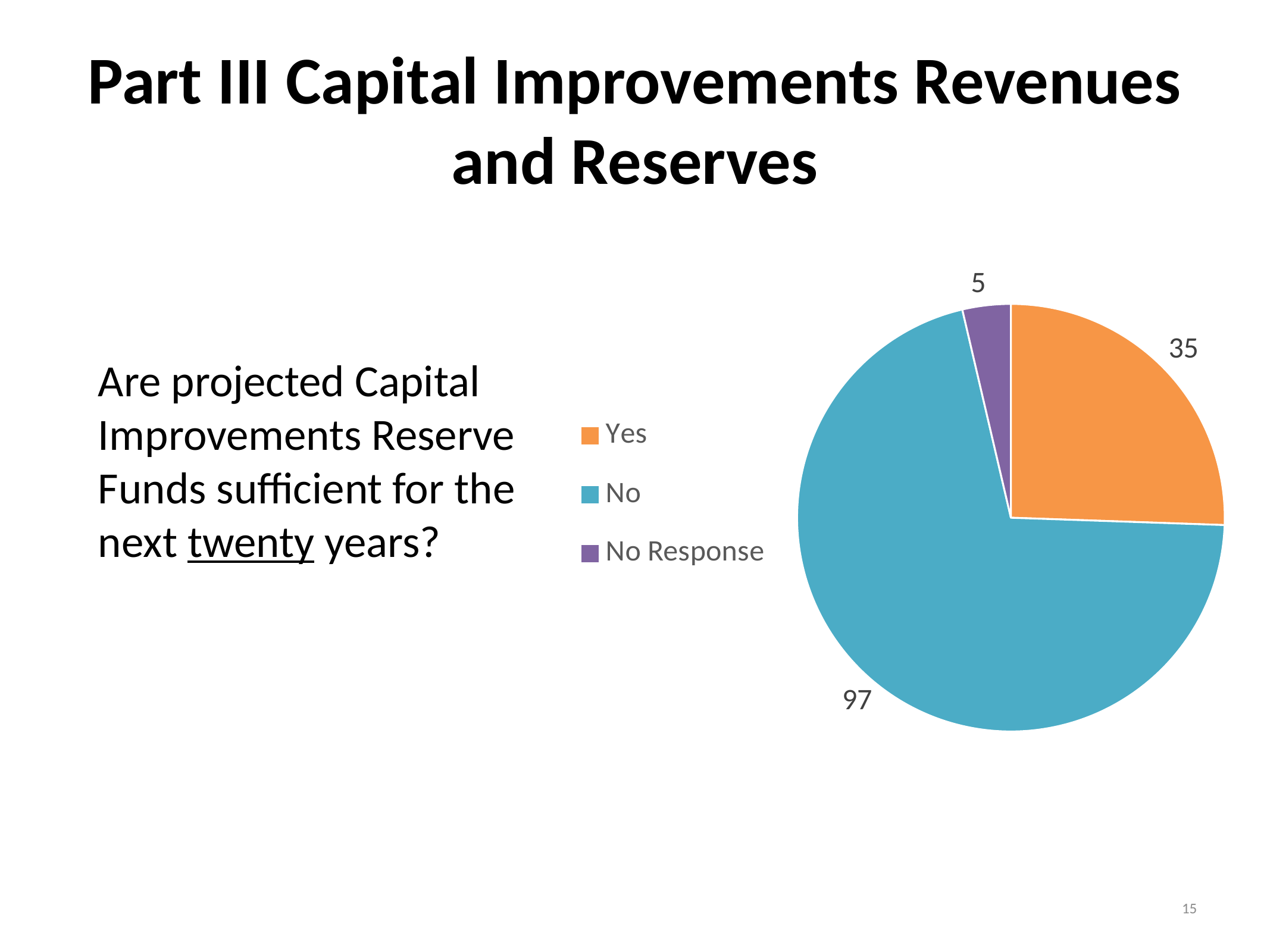
Which is larger, the Yes slice or the No Response slice? Yes What value is shown for the No Response slice of the pie chart? 5 What is the total of all the values shown in the pie chart? 137 Which category has the largest slice in the pie chart? No What are the three legend entries of the pie chart? Yes, No, No Response How many categories does the pie chart show? 3 What is the difference between the No value and the Yes value? 62 What kind of chart is shown on the slide? Pie chart What value is shown for the No slice of the pie chart? 97 What value is shown for the Yes slice of the pie chart? 35 What colour is the No slice in the pie chart? Blue Which category has the smallest slice in the pie chart? No Response